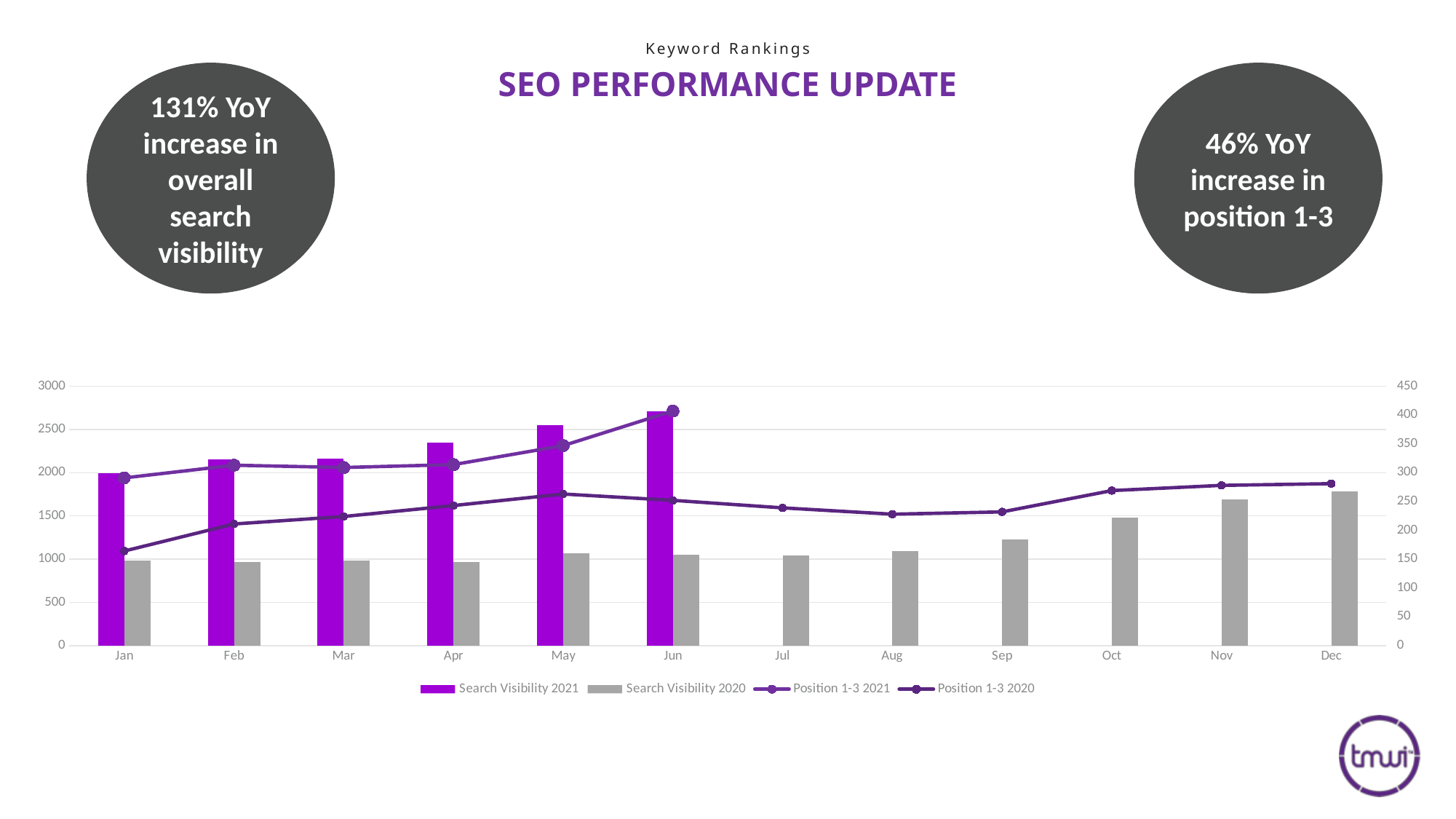
Do the Search Visibility 2021 bars rise or fall from Jan to Jun? rise What kind of chart is shown on the slide? A combination bar and line chart Is the Position 1-3 2020 value for Jan greater or less than 200 on the right-hand axis? less How many months are shown along the x axis of the chart? 12 What is the title of the chart on the slide? SEO PERFORMANCE UPDATE Which is larger in May: Search Visibility 2021 or Search Visibility 2020? Search Visibility 2021 Is the Search Visibility 2021 value for Jun greater or less than 2500? greater Is the Search Visibility 2020 value for Sep greater or less than 1000? greater In which month is the Search Visibility 2021 bar highest? Jun In which month is the Search Visibility 2020 bar highest? Dec In which month is the Search Visibility 2021 bar lowest? Jan How many series does the chart legend list? 4